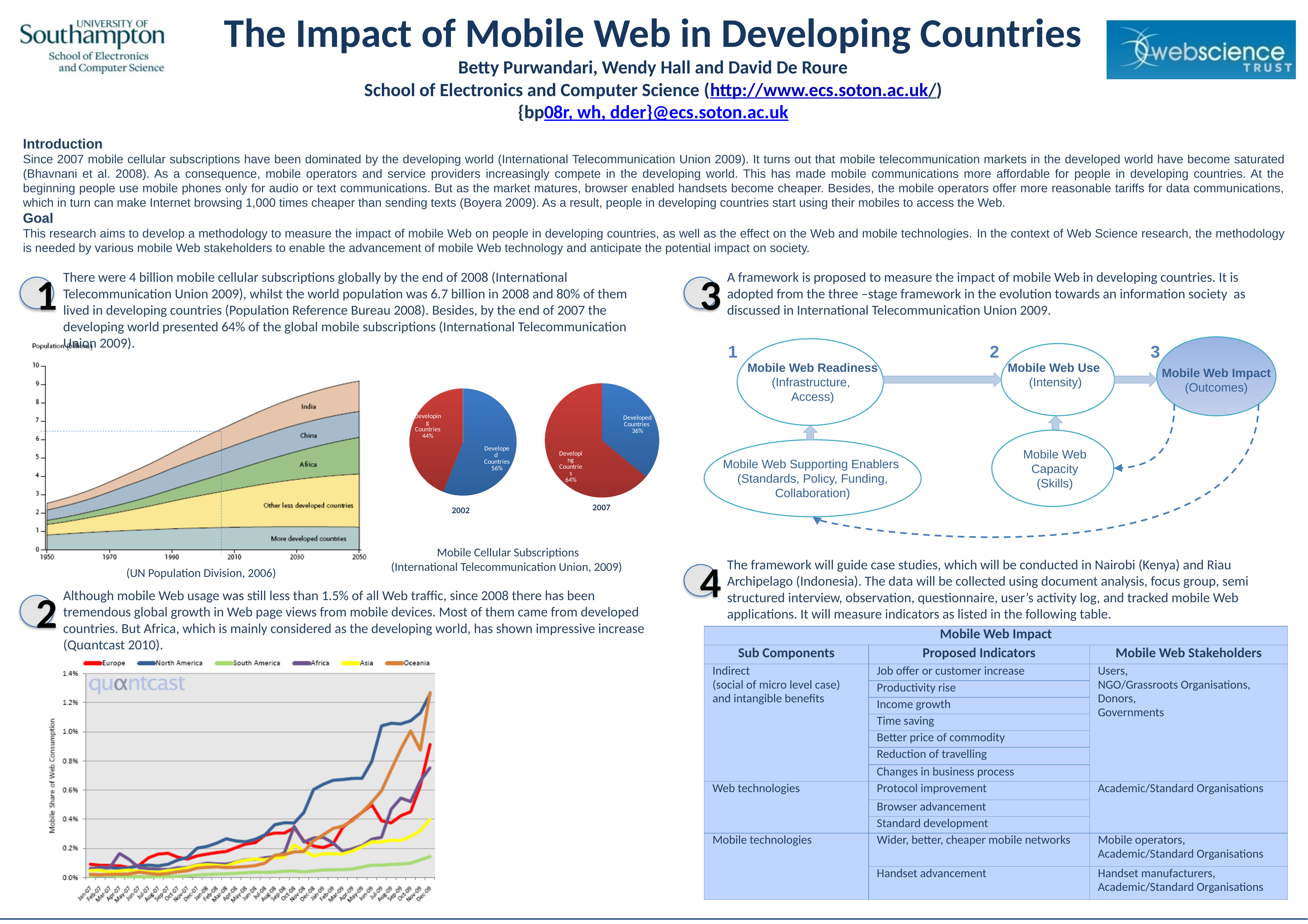
How many series does the legend of the Quantcast mobile share of web consumption line chart list? 6 How many slices does each Mobile Cellular Subscriptions pie chart have? 2 In the 2007 Mobile Cellular Subscriptions pie chart, what share is shown for Developing Countries? 64% In the 2002 Mobile Cellular Subscriptions pie chart, what share is shown for Developed Countries? 56% In the 2007 Mobile Cellular Subscriptions pie chart, what share is shown for Developed Countries? 36% By how many percentage points did the Developing Countries share of mobile cellular subscriptions change between the 2002 and 2007 pie charts? 20 percentage points What kind of chart is the UN Population Division chart on the left of the slide? Stacked area chart In the Quantcast line chart, which region has the lowest mobile share of web consumption at Dec-09? South America In the UN Population Division chart, does total population rise or fall from 1950 to 2050? Rise In the 2002 Mobile Cellular Subscriptions pie chart, what share is shown for Developing Countries? 44% In the 2007 Mobile Cellular Subscriptions pie chart, which slice is larger, Developed Countries or Developing Countries? Developing Countries In the Quantcast line chart, is the value for North America at Dec-09 greater or less than 1.0%? greater